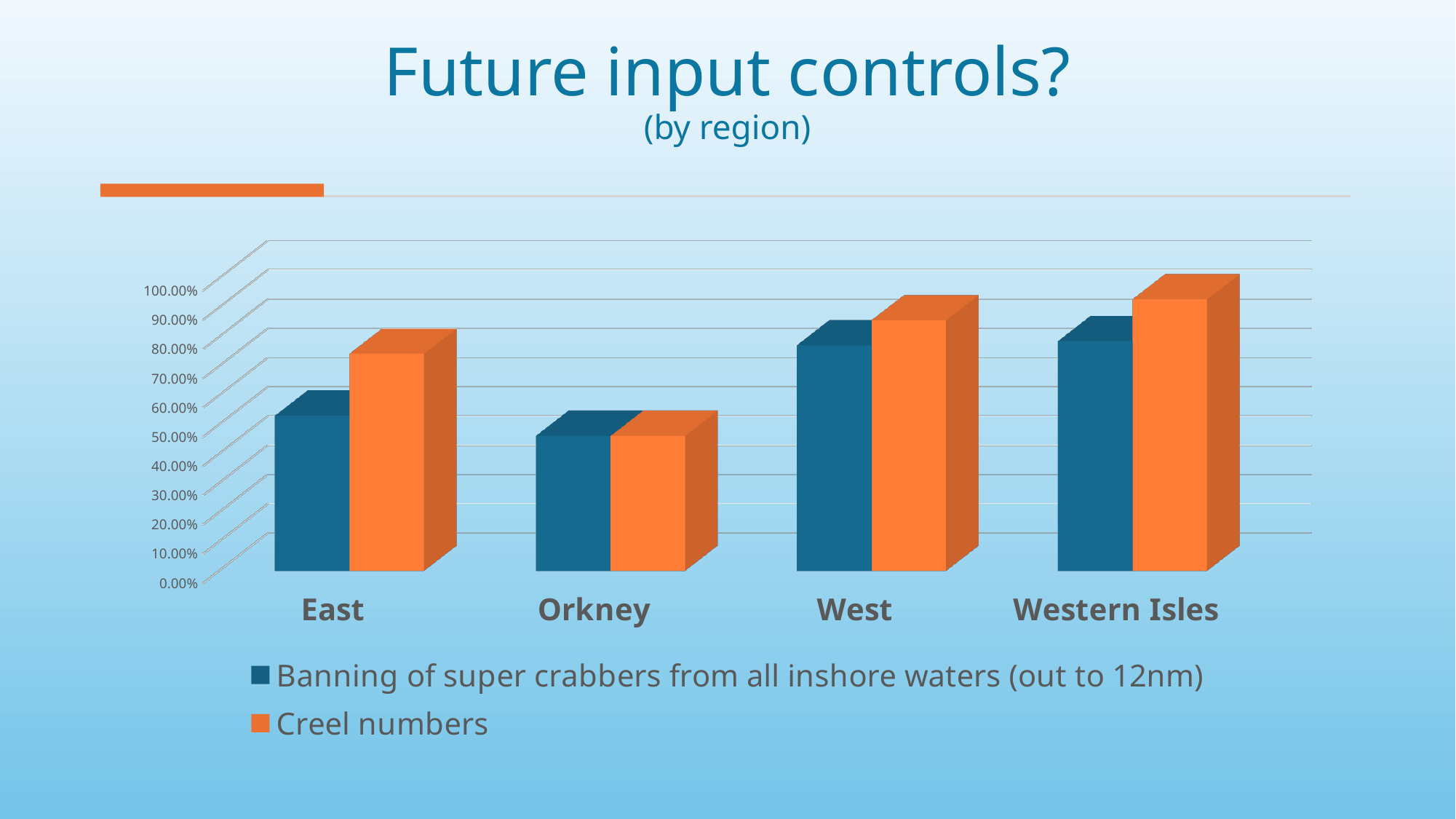
What kind of chart is shown on the slide? bar chart For Western Isles, which series has the larger value: Banning of super crabbers or Creel numbers? Creel numbers Is the value for Creel numbers in Western Isles greater or less than 90.00%? greater Is the value for Banning of super crabbers in East greater or less than 70.00%? less Which region has the highest value for Creel numbers? Western Isles Which colour represents the Creel numbers series in the chart? orange Which region has the lowest value for Creel numbers? Orkney Is the value for Creel numbers in Orkney greater or less than 60.00%? less Which region has the lowest value for Banning of super crabbers from all inshore waters (out to 12nm)? Orkney How many series does the chart's legend list? 2 How many regions are shown on the x axis of the chart? 4 For East, which series has the larger value: Banning of super crabbers or Creel numbers? Creel numbers